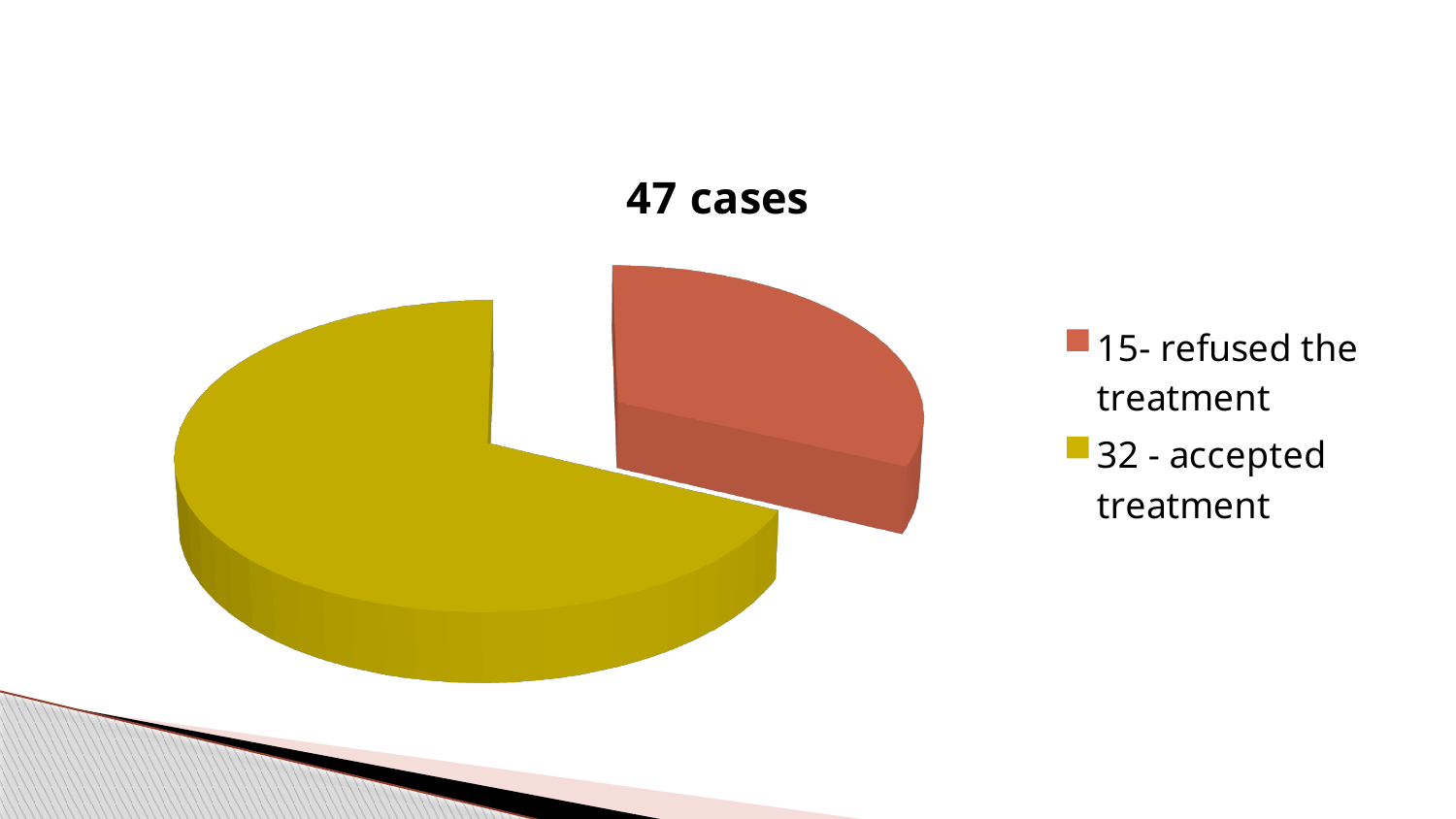
What kind of chart is shown on the slide? Pie chart What is the total number of cases represented in the pie chart? 47 How many entries does the legend list? 2 How many slices does the pie chart have? 2 How many cases refused the treatment? 15 Which category has the largest slice of the pie? 32 - accepted treatment How many cases accepted treatment? 32 What is the difference between the number of cases that accepted treatment and the number that refused the treatment? 17 What is the title of the chart? 47 cases Which is larger: the number of cases that accepted treatment or the number that refused the treatment? Accepted treatment Which category has the smallest slice of the pie? 15- refused the treatment What colour is the slice for cases that refused the treatment? Red